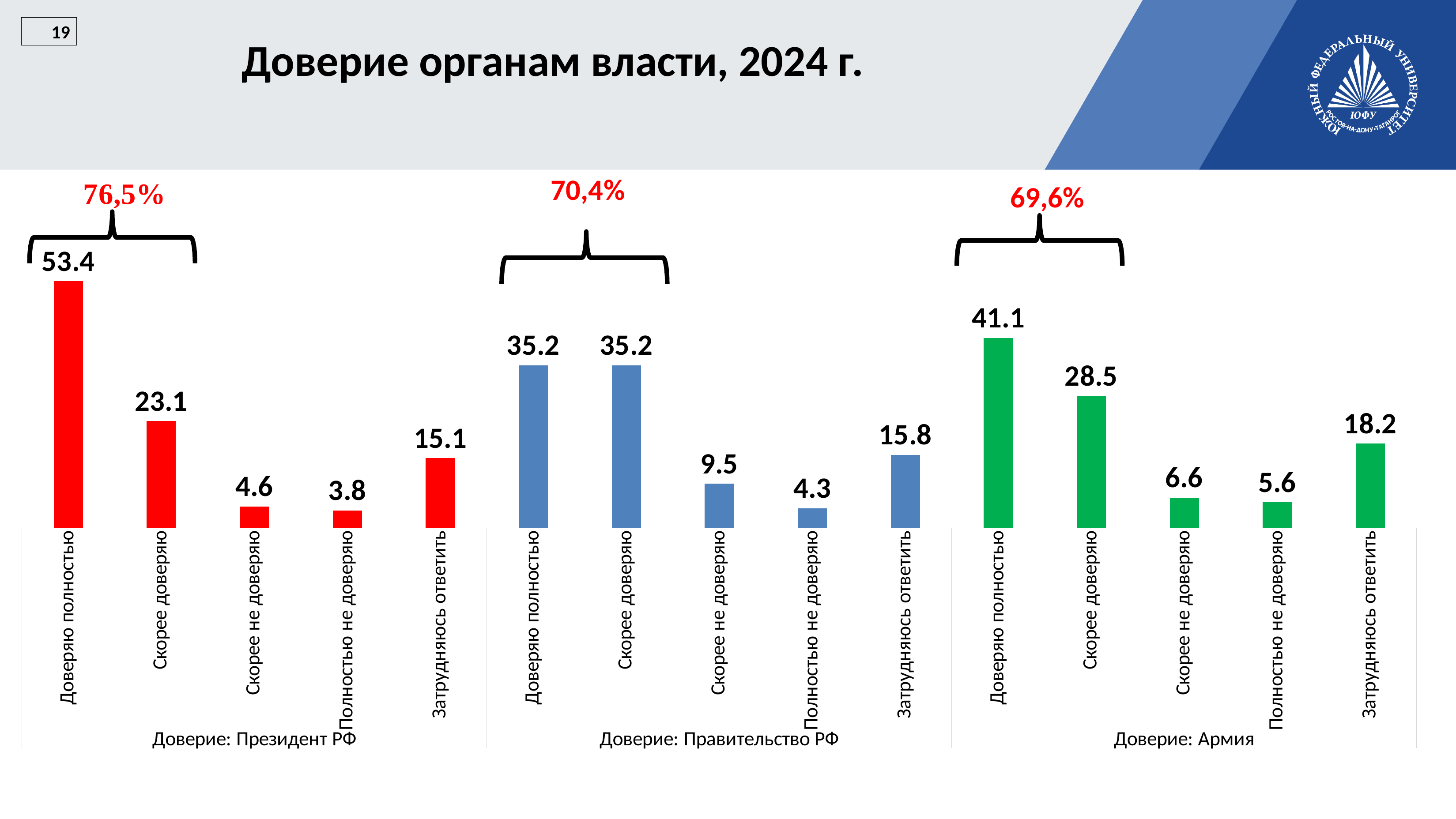
Which category has the highest value across the whole chart? Доверяю полностью (Доверие: Президент РФ) What combined percentage is shown in red above the "Доверие: Правительство РФ" group? 70,4% How many groups (органы власти) are shown along the x axis? 3 What is the value for "Скорее не доверяю" in the "Доверие: Правительство РФ" group? 9.5 What is the value for "Доверяю полностью" in the "Доверие: Президент РФ" group? 53.4 What colour are the bars for the "Доверие: Армия" group? Green Which category has the lowest value in the "Доверие: Президент РФ" group? Полностью не доверяю What kind of chart is shown on the slide? Bar chart Which is larger: "Затрудняюсь ответить" for "Доверие: Правительство РФ" or "Затрудняюсь ответить" for "Доверие: Президент РФ"? Доверие: Правительство РФ How many bars are plotted in the chart in total? 15 What is the value for "Затрудняюсь ответить" in the "Доверие: Армия" group? 18.2 What is the difference between "Доверяю полностью" and "Скорее доверяю" in the "Доверие: Армия" group? 12.6